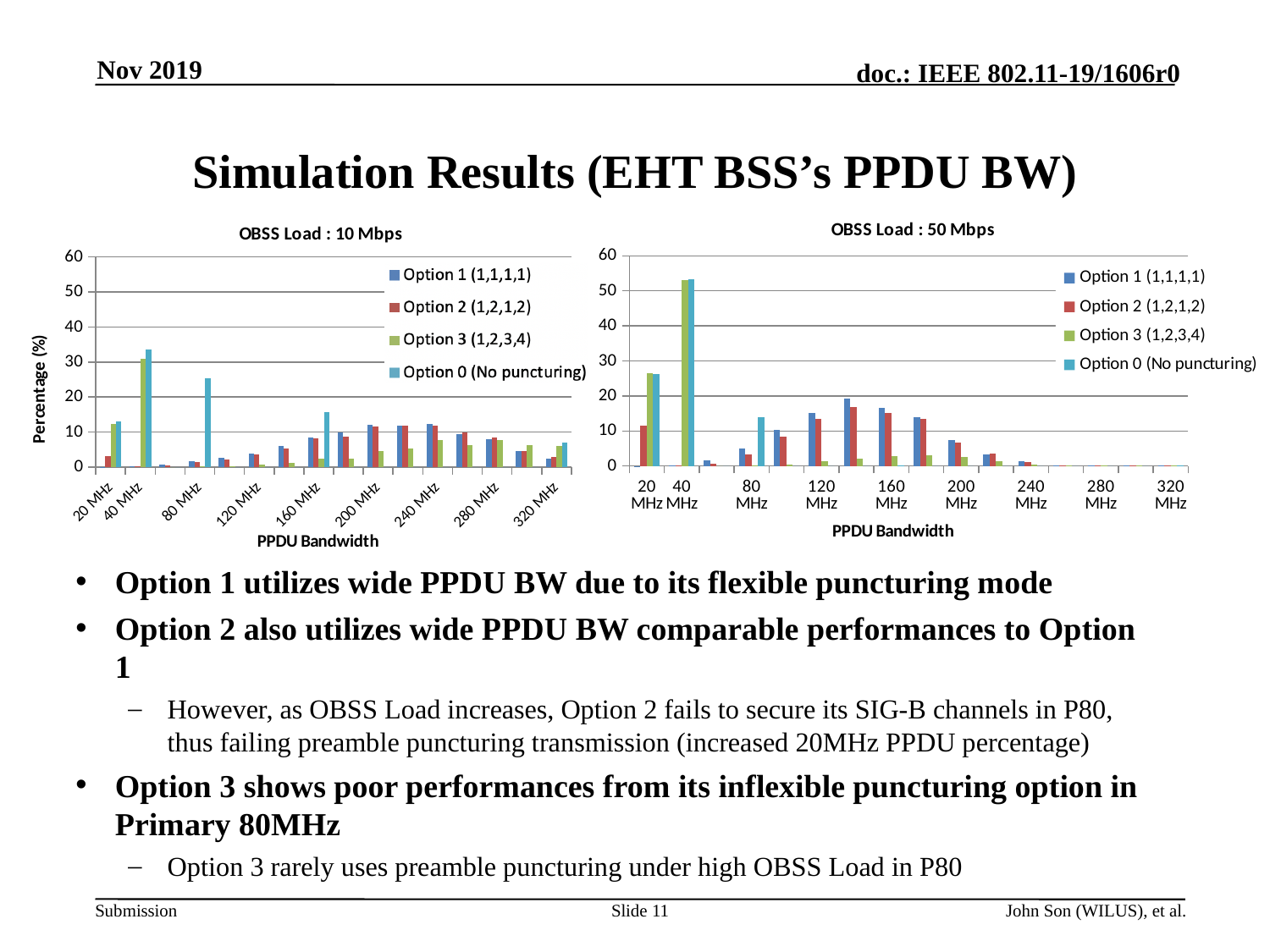
In the 'OBSS Load : 10 Mbps' chart, which is larger: Option 0 (No puncturing) at 40 MHz or Option 0 (No puncturing) at 80 MHz? 40 MHz What kind of chart is the 'OBSS Load : 10 Mbps' chart on the left? bar chart In the 'OBSS Load : 50 Mbps' chart, at which PPDU bandwidth does the tallest bar appear? 40 MHz In the 'OBSS Load : 50 Mbps' chart, which is larger: Option 3 (1,2,3,4) at 40 MHz or Option 1 (1,1,1,1) at 120 MHz? Option 3 (1,2,3,4) at 40 MHz In the 'OBSS Load : 10 Mbps' chart, is the value for Option 0 (No puncturing) at 40 MHz greater or less than 30? greater In the 'OBSS Load : 50 Mbps' chart, is the value for Option 2 (1,2,1,2) at 20 MHz greater or less than 20? less In the 'OBSS Load : 50 Mbps' chart, is the value for Option 1 (1,1,1,1) at 120 MHz greater or less than 10? greater What is the title of the chart on the right side of the slide? OBSS Load : 50 Mbps How many series does the legend of the 'OBSS Load : 50 Mbps' chart list? 4 What is the label of the vertical axis on the 'OBSS Load : 10 Mbps' chart? Percentage (%)